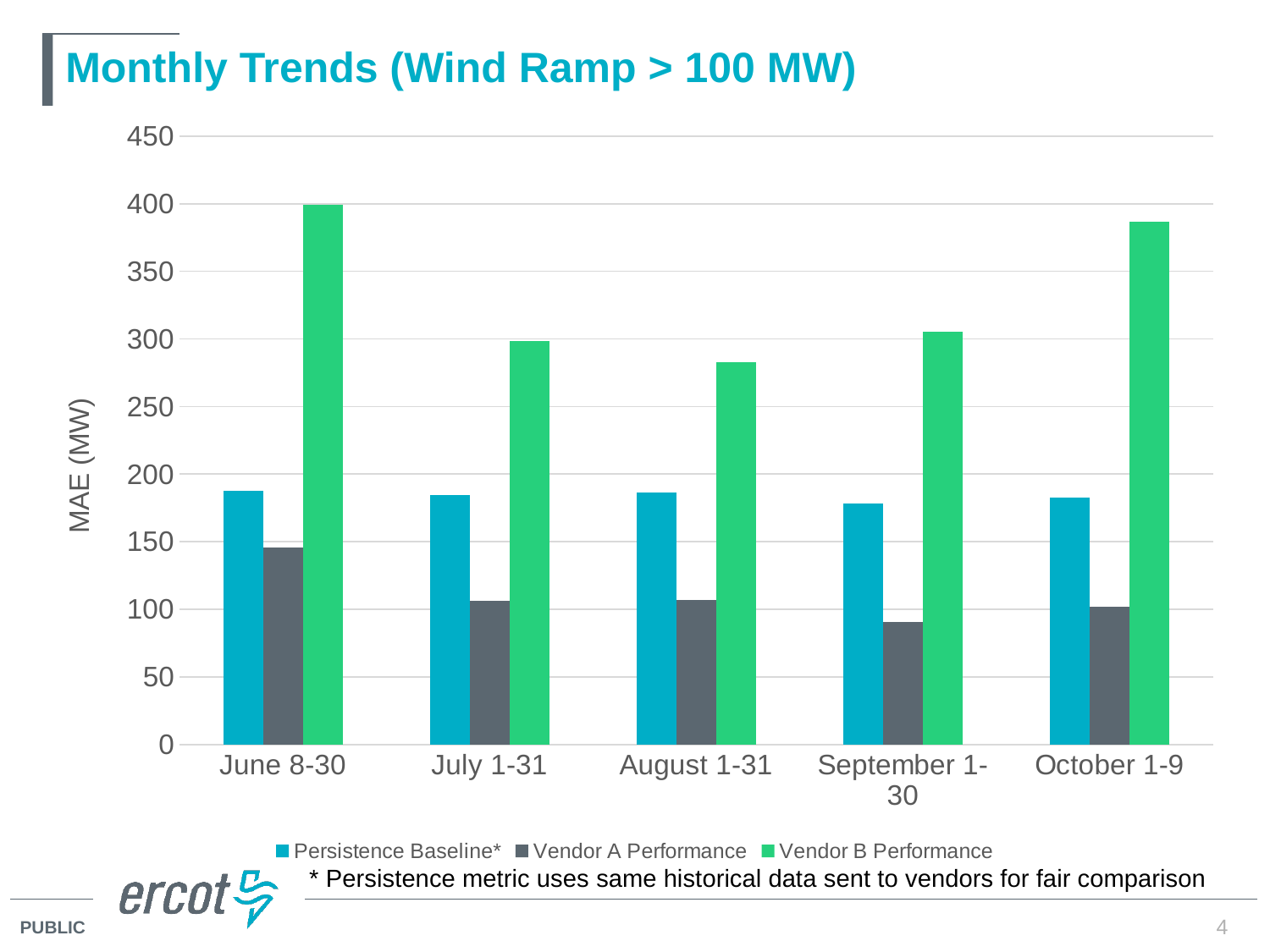
How many series does the legend list? 3 Is the Persistence Baseline value for June 8-30 greater or less than 200? less Is the Vendor A Performance value for September 1-30 greater or less than 100? less For August 1-31, which is larger: the Persistence Baseline or the Vendor B Performance value? Vendor B Performance What kind of chart is shown on the slide? Bar chart What is the title of the chart? Monthly Trends (Wind Ramp > 100 MW) What is the label of the y axis? MAE (MW) Is the Vendor B Performance value for June 8-30 greater or less than 350? greater In which period is the Vendor A Performance value lowest? September 1-30 For October 1-9, which is larger: the Vendor A Performance or the Persistence Baseline value? Persistence Baseline How many time periods are shown on the x axis? 5 In which period is the Vendor A Performance value highest? June 8-30